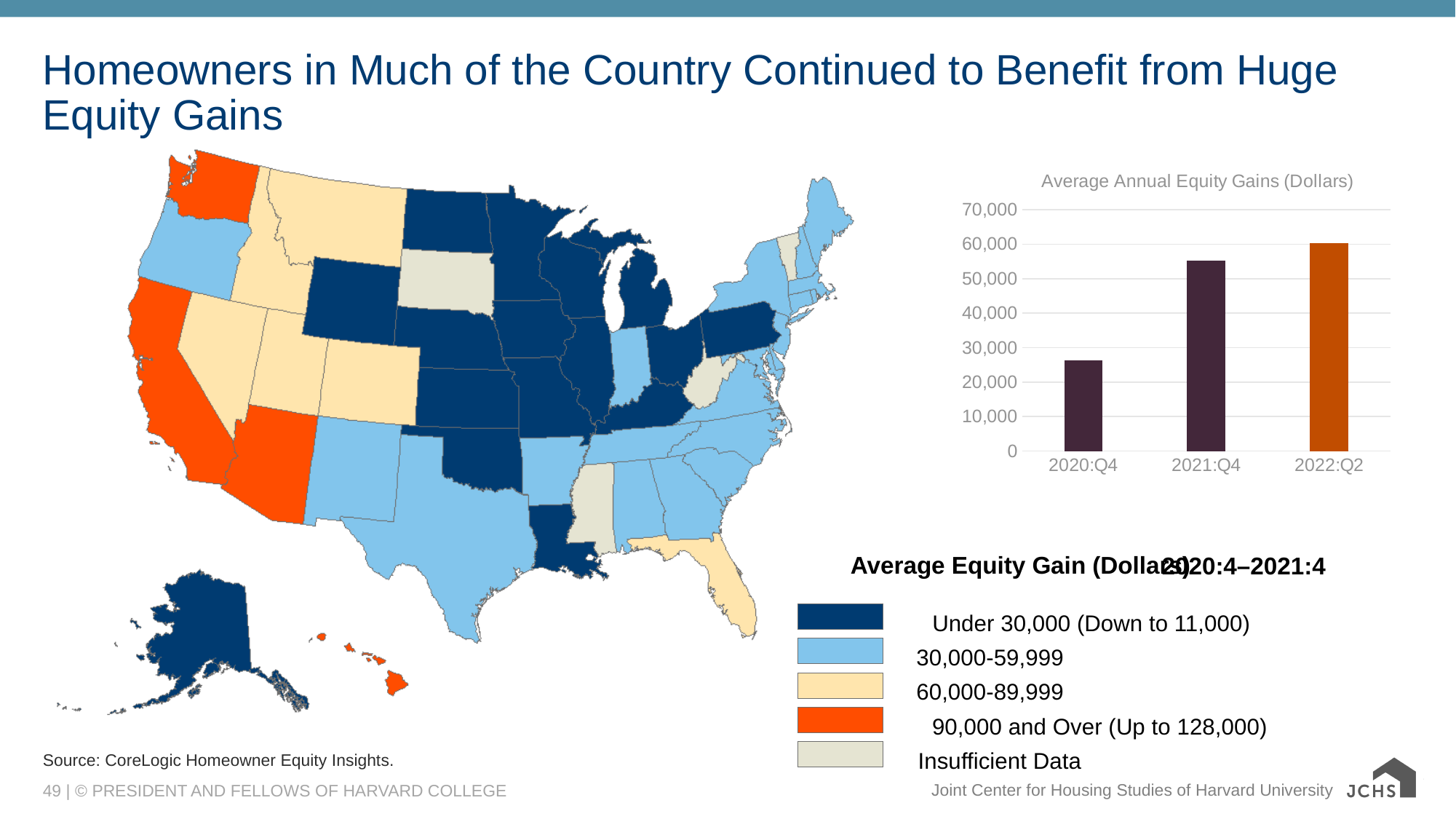
What kind of chart is the 'Average Annual Equity Gains (Dollars)' chart on the right of the slide? bar chart In the 'Average Annual Equity Gains (Dollars)' chart, is the value for 2020:Q4 greater or less than 30,000? less In the 'Average Annual Equity Gains (Dollars)' chart, do the values rise or fall from 2020:Q4 to 2022:Q2? rise On the map, what range does the orange colour represent in the legend? 90,000 and Over (Up to 128,000) In the 'Average Annual Equity Gains (Dollars)' chart, is the value for 2021:Q4 greater or less than 50,000? greater In the 'Average Annual Equity Gains (Dollars)' chart, is the value for 2020:Q4 greater or less than 20,000? greater What is the highest tick value shown on the vertical axis of the 'Average Annual Equity Gains (Dollars)' chart? 70,000 In the 'Average Annual Equity Gains (Dollars)' chart, which period has the highest value? 2022:Q2 How many bars are plotted in the 'Average Annual Equity Gains (Dollars)' chart? 3 In the 'Average Annual Equity Gains (Dollars)' chart, which is larger, the value for 2020:Q4 or the value for 2021:Q4? 2021:Q4 In the 'Average Annual Equity Gains (Dollars)' chart, which period has the lowest value? 2020:Q4